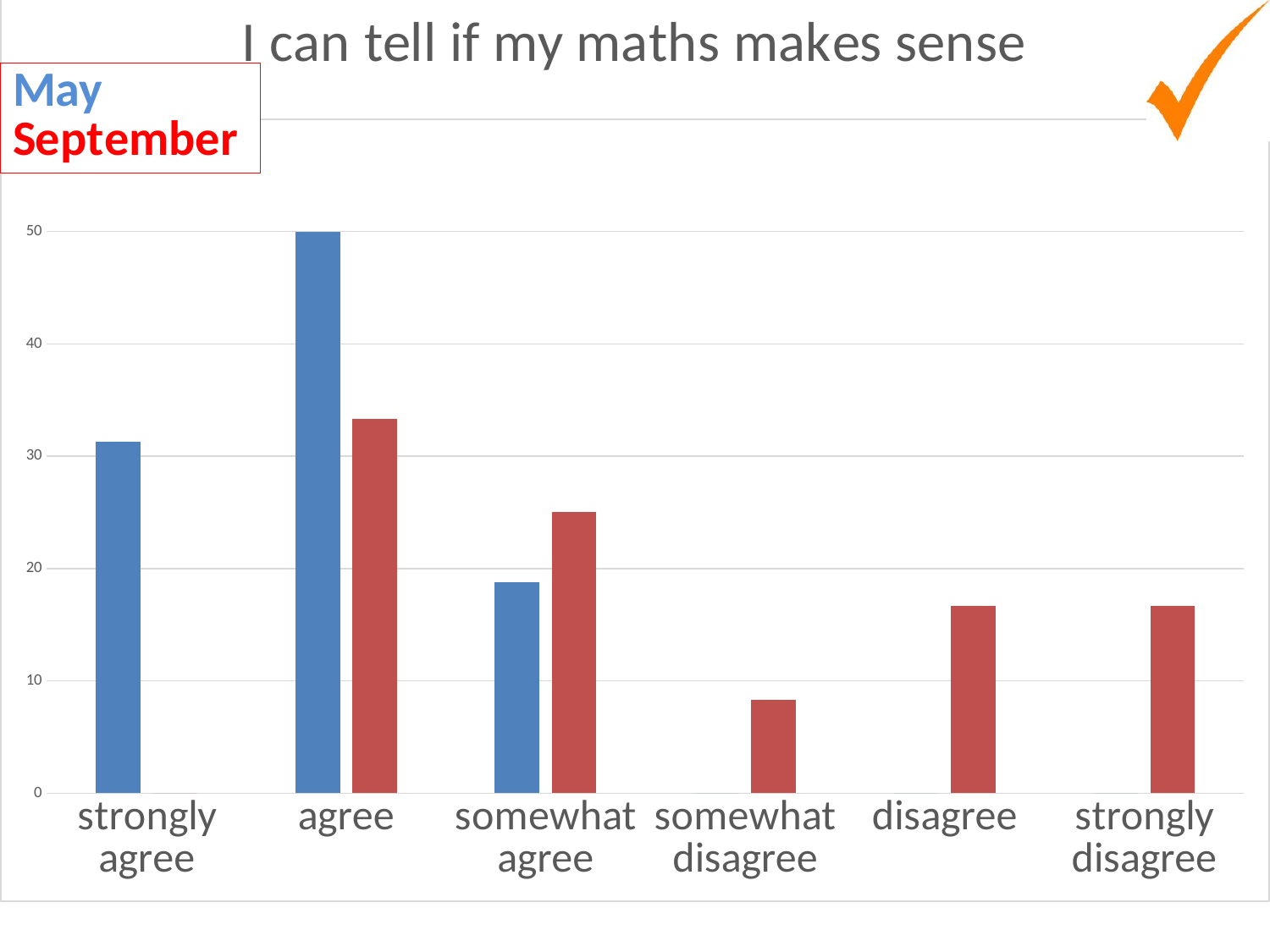
What is the title of the chart? I can tell if my maths makes sense Which category has the highest September value? agree Is the September value for "somewhat agree" greater or less than 20? greater Which category has the highest May value? agree What is the May value for "agree"? 50 Is the September value for "somewhat disagree" greater or less than 10? less How many series does the legend list? 2 Is the May value for "strongly agree" greater or less than 30? greater How many categories are shown on the x axis? 6 For "agree", which series has the larger value, May or September? May For "somewhat agree", which series has the larger value, May or September? September What kind of chart is shown on the slide? bar chart